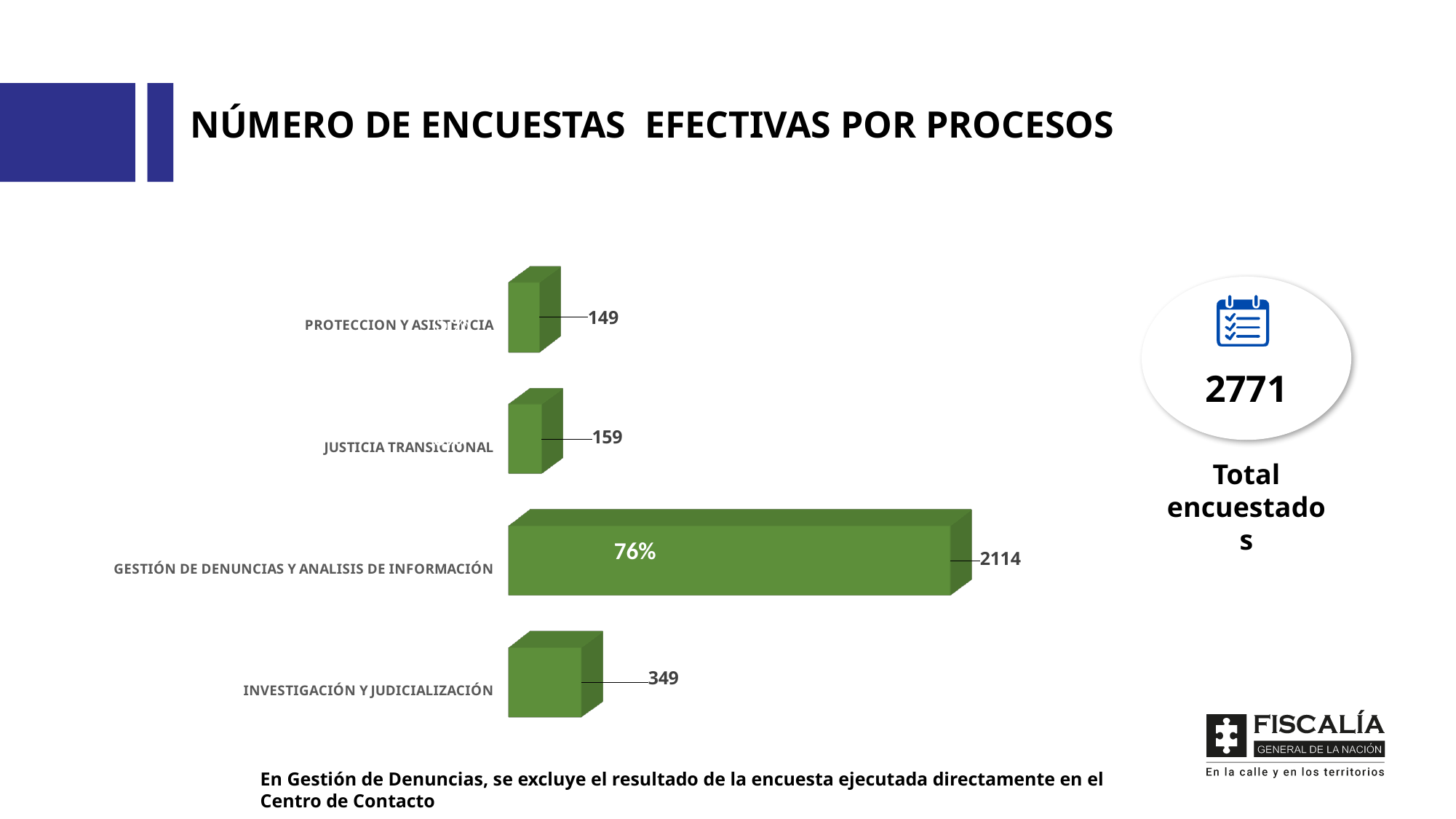
What kind of chart is shown on the slide? Bar chart What is the value for INVESTIGACIÓN Y JUDICIALIZACIÓN? 349 Which process has the highest number of effective surveys? GESTIÓN DE DENUNCIAS Y ANALISIS DE INFORMACIÓN What is the difference between the values for INVESTIGACIÓN Y JUDICIALIZACIÓN and JUSTICIA TRANSICIONAL? 190 What is the value for GESTIÓN DE DENUNCIAS Y ANALISIS DE INFORMACIÓN? 2114 Which is larger, the value for JUSTICIA TRANSICIONAL or the value for PROTECCION Y ASISTENCIA? JUSTICIA TRANSICIONAL How many processes (categories) are shown in the chart? 4 Which process has the lowest number of effective surveys? PROTECCION Y ASISTENCIA What percentage label is printed inside the bar for GESTIÓN DE DENUNCIAS Y ANALISIS DE INFORMACIÓN? 76% What is the total number of respondents (Total encuestados) shown on the slide? 2771 What is the value for PROTECCION Y ASISTENCIA? 149 What is the value for JUSTICIA TRANSICIONAL? 159